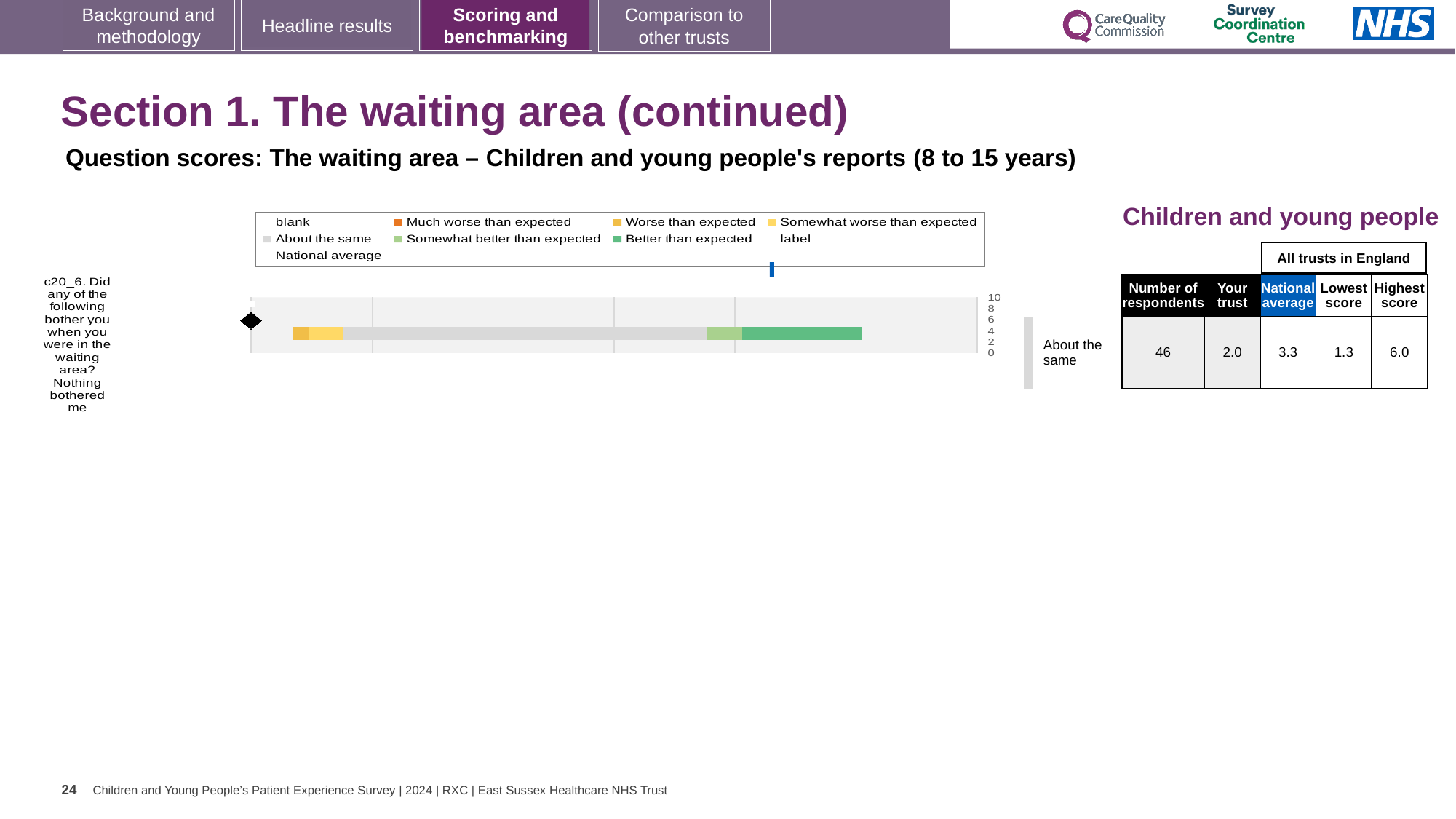
Which question code is plotted in the chart? c20_6 In the table beside the chart, what is the 'Your trust' score for question c20_6? 2.0 How many entries does the chart legend list? 9 In the table beside the chart, what is the number of respondents for question c20_6? 46 Which is larger for question c20_6: the 'Your trust' score or the national average? National average What benchmark category is shown to the right of the bar for question c20_6? About the same In the table beside the chart, what is the highest score among all trusts in England for question c20_6? 6.0 In the table beside the chart, what is the national average score for question c20_6? 3.3 What is the difference between the highest score and the lowest score for question c20_6? 4.7 What kind of chart is shown on the slide? bar chart How many survey questions are plotted in the chart? 1 In the chart legend, what colour represents 'Better than expected'? green